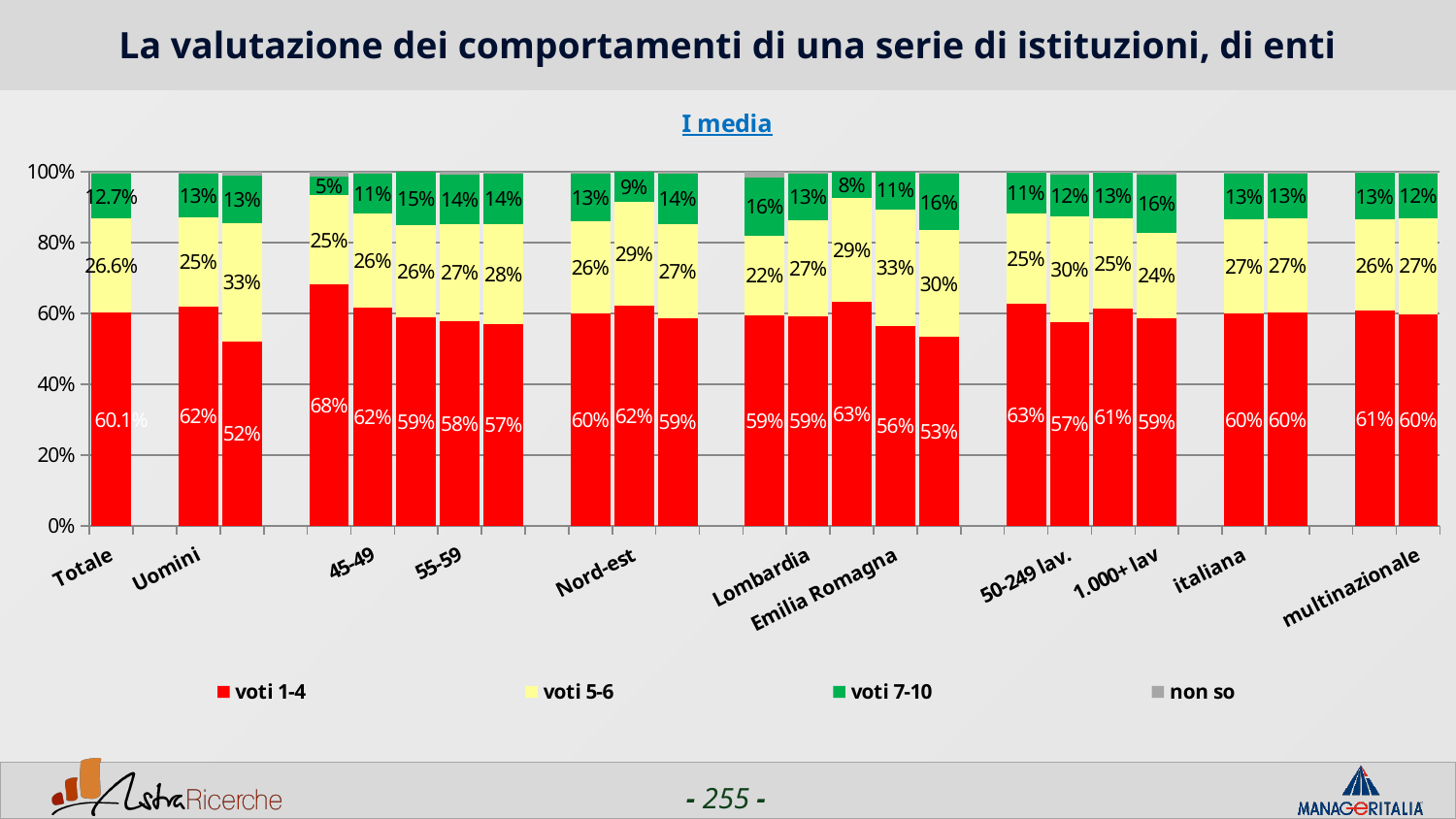
What is the value of 'voti 5-6' for the Totale bar? 26.6% Which legend entry is shown in green? voti 7-10 What kind of chart is shown on the slide? stacked bar chart What is the subtitle shown above the chart? I media What is the value of 'voti 7-10' for the Totale bar? 12.7% Is the 'voti 1-4' value for Totale greater or less than 40%? greater What is the difference between 'voti 5-6' and 'voti 7-10' for the Totale bar? 13.9 percentage points What is the value of 'voti 1-4' for the Totale bar? 60.1% What is the value of 'voti 1-4' for Uomini? 62% What is the value of 'voti 5-6' for Uomini? 25% How many series does the legend list? 4 Which is larger, the 'voti 1-4' value for Uomini or for Totale? Uomini